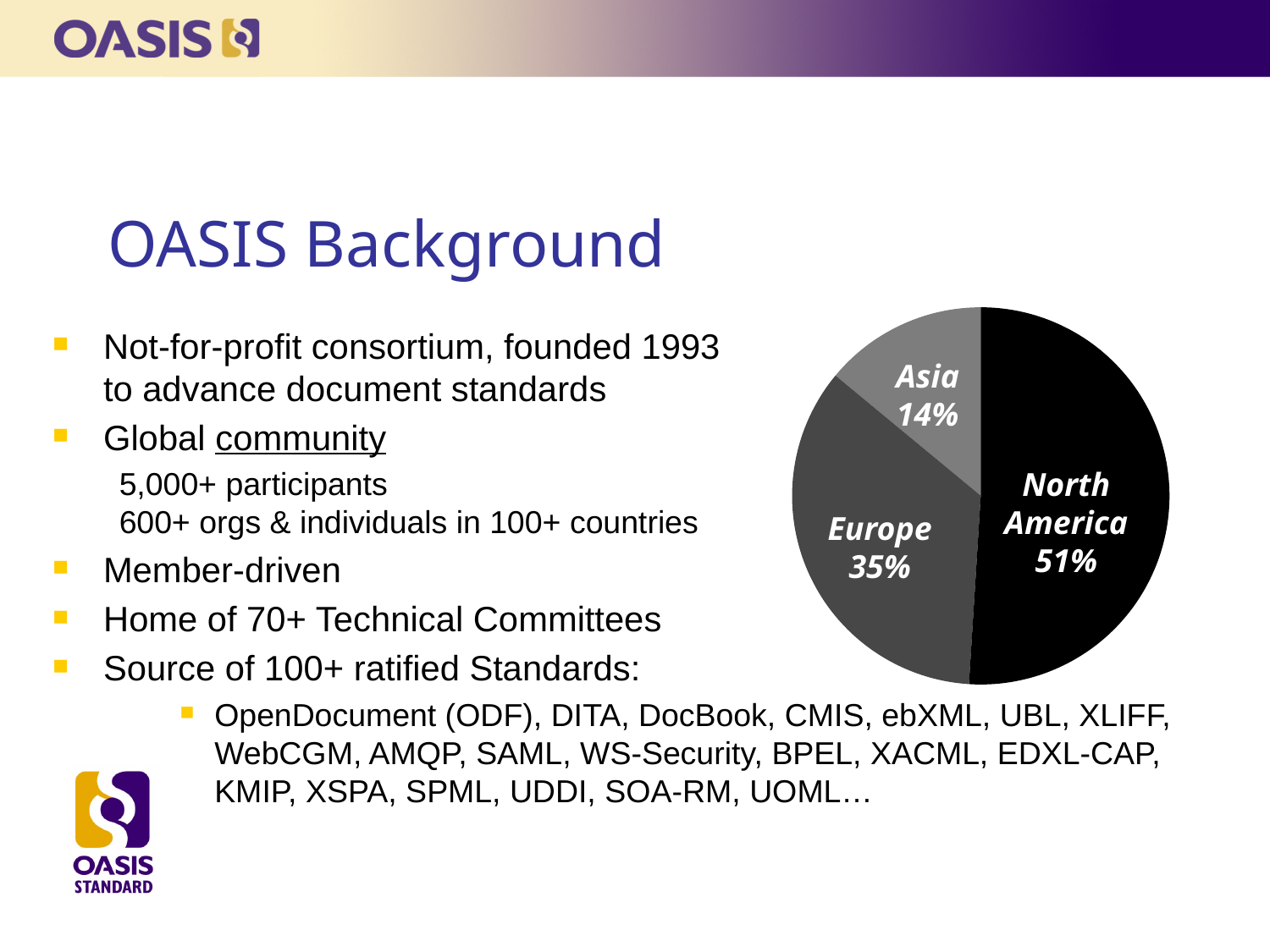
How many slices does the pie chart have? 3 Which region has the largest slice of the pie? North America What kind of chart is shown on the slide? pie chart What is the difference in percentage points between Europe and Asia? 21 What is the difference in percentage points between North America and Europe? 16 Which is larger, the share for Europe or the share for Asia? Europe What share of the pie does Asia have? 14% What share of the pie does Europe have? 35% What share of the pie does North America have? 51% Which region has the smallest slice of the pie? Asia Which slice of the pie is coloured black? North America Is the share for North America greater or less than 50%? greater